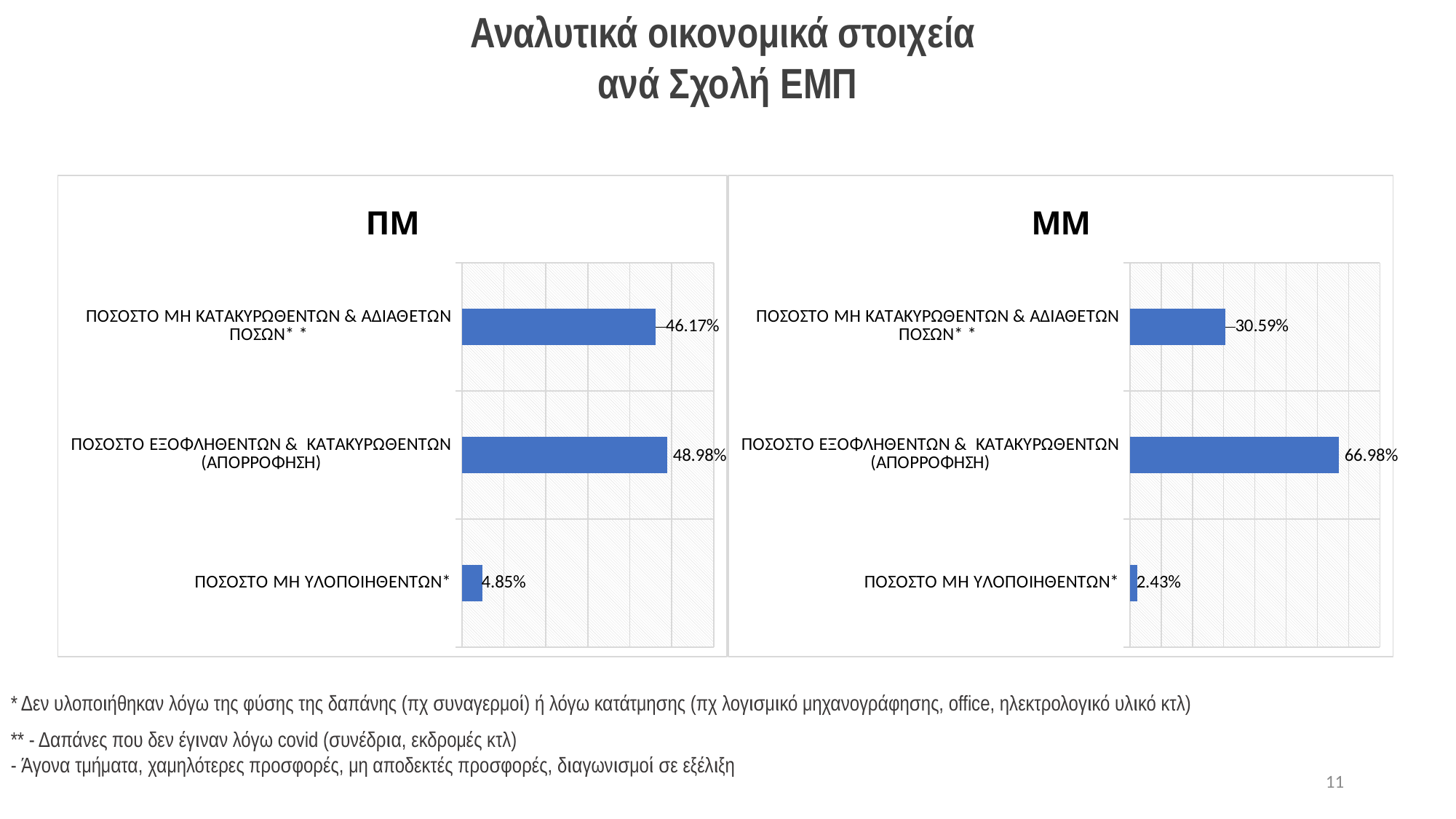
In the ΠΜ chart, what is the value for ΠΟΣΟΣΤΟ ΕΞΟΦΛΗΘΕΝΤΩΝ & ΚΑΤΑΚΥΡΩΘΕΝΤΩΝ (ΑΠΟΡΡΟΦΗΣΗ)? 48.98% In the ΠΜ chart, what is the difference between ΠΟΣΟΣΤΟ ΕΞΟΦΛΗΘΕΝΤΩΝ & ΚΑΤΑΚΥΡΩΘΕΝΤΩΝ (ΑΠΟΡΡΟΦΗΣΗ) and ΠΟΣΟΣΤΟ ΜΗ ΥΛΟΠΟΙΗΘΕΝΤΩΝ? 44.13% How many categories are shown in the ΜΜ chart? 3 What kind of chart is the ΠΜ chart? Bar chart In the ΜΜ chart, what is the value for ΠΟΣΟΣΤΟ ΕΞΟΦΛΗΘΕΝΤΩΝ & ΚΑΤΑΚΥΡΩΘΕΝΤΩΝ (ΑΠΟΡΡΟΦΗΣΗ)? 66.98% In the ΠΜ chart, what is the value for ΠΟΣΟΣΤΟ ΜΗ ΚΑΤΑΚΥΡΩΘΕΝΤΩΝ & ΑΔΙΑΘΕΤΩΝ ΠΟΣΩΝ? 46.17% In the ΜΜ chart, which category has the highest value? ΠΟΣΟΣΤΟ ΕΞΟΦΛΗΘΕΝΤΩΝ & ΚΑΤΑΚΥΡΩΘΕΝΤΩΝ (ΑΠΟΡΡΟΦΗΣΗ) In the ΜΜ chart, what is the difference between ΠΟΣΟΣΤΟ ΕΞΟΦΛΗΘΕΝΤΩΝ & ΚΑΤΑΚΥΡΩΘΕΝΤΩΝ (ΑΠΟΡΡΟΦΗΣΗ) and ΠΟΣΟΣΤΟ ΜΗ ΚΑΤΑΚΥΡΩΘΕΝΤΩΝ & ΑΔΙΑΘΕΤΩΝ ΠΟΣΩΝ? 36.39% In the ΜΜ chart, what is the value for ΠΟΣΟΣΤΟ ΜΗ ΥΛΟΠΟΙΗΘΕΝΤΩΝ? 2.43% Which chart has the larger value for ΠΟΣΟΣΤΟ ΜΗ ΥΛΟΠΟΙΗΘΕΝΤΩΝ, ΠΜ or ΜΜ? ΠΜ In the ΠΜ chart, which category has the lowest value? ΠΟΣΟΣΤΟ ΜΗ ΥΛΟΠΟΙΗΘΕΝΤΩΝ Which chart has the larger value for ΠΟΣΟΣΤΟ ΜΗ ΚΑΤΑΚΥΡΩΘΕΝΤΩΝ & ΑΔΙΑΘΕΤΩΝ ΠΟΣΩΝ, ΠΜ or ΜΜ? ΠΜ